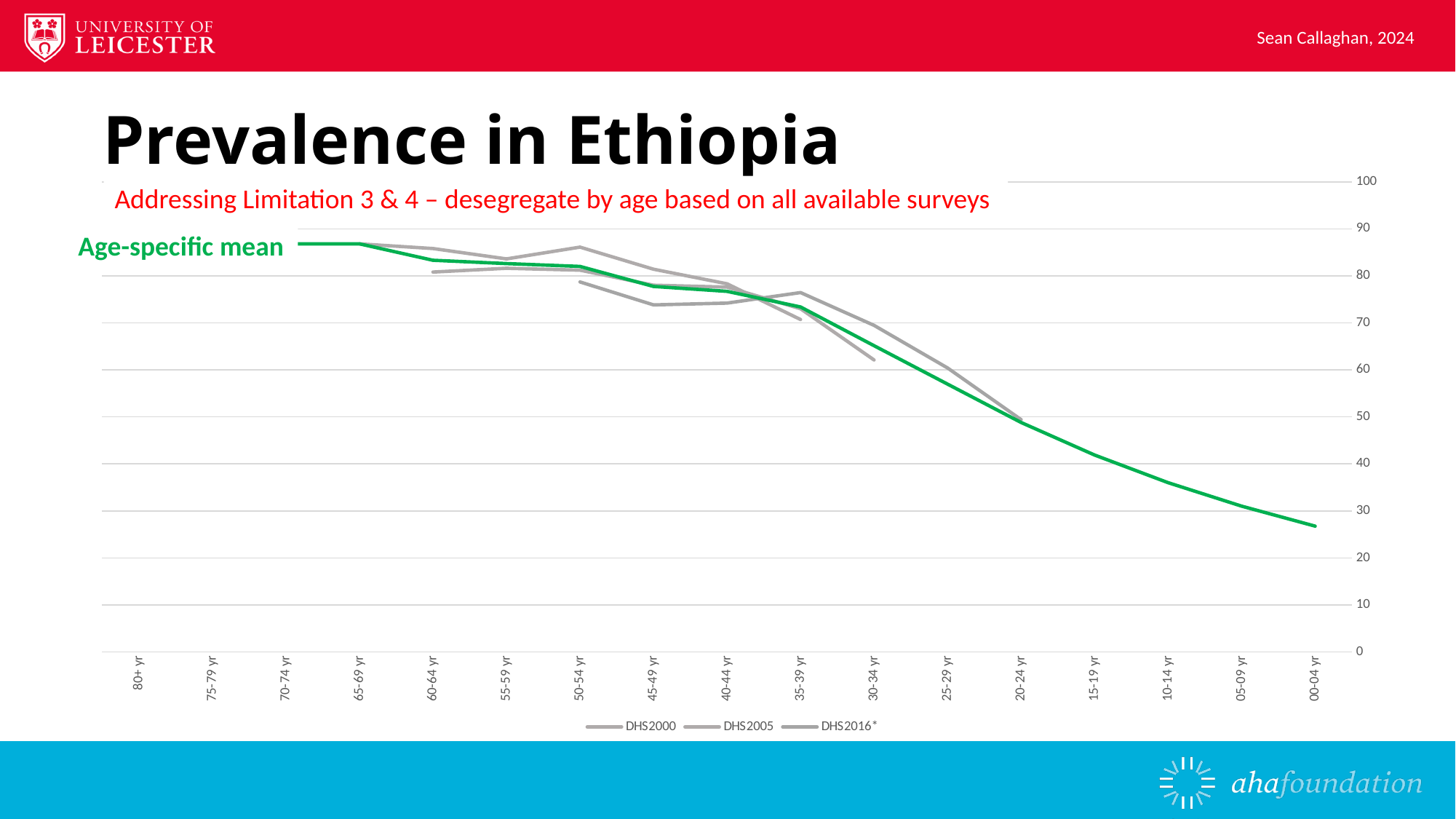
Is the Age-specific mean value for 25-29 yr greater or less than 50? greater What is the title of the slide containing the chart? Prevalence in Ethiopia How many series does the legend list? 3 Is the Age-specific mean value for 00-04 yr greater or less than 30? less Is the Age-specific mean value for 10-14 yr greater or less than 40? less What kind of chart is shown on the slide? line chart Do the values of the Age-specific mean line rise or fall moving from the 80+ yr group to the 00-04 yr group? fall What label is given to the green line on the chart? Age-specific mean How many age-group categories are shown on the x axis? 17